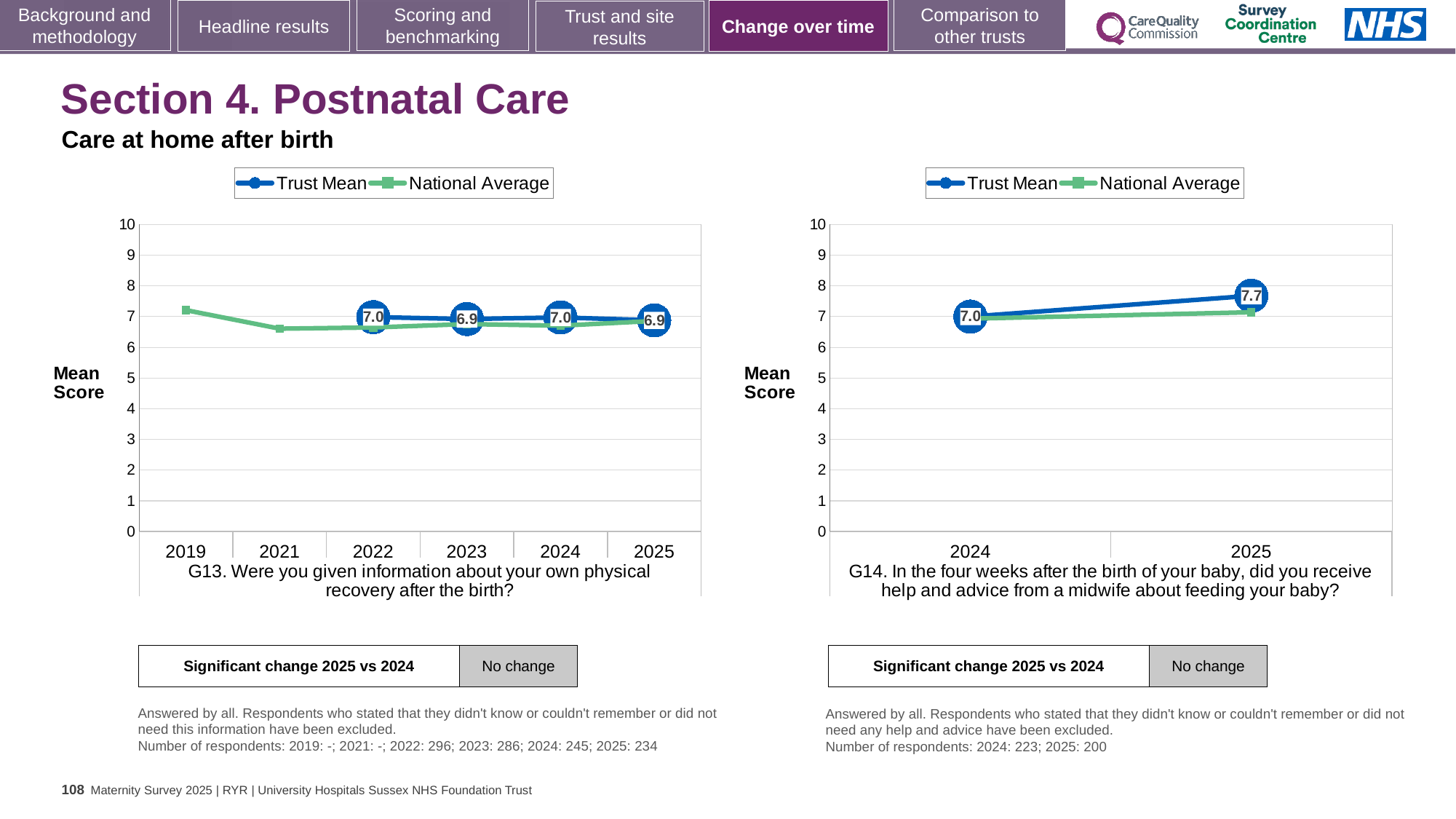
In the G13 chart on the left, what is the Trust Mean for 2022? 7.0 How many years are shown on the x axis of the G13 chart on the left? 6 In the G14 chart on the right, by how much did the Trust Mean change from 2024 to 2025? 0.7 In the G14 chart on the right, what is the Trust Mean for 2025? 7.7 In the G14 chart on the right, which is larger in 2025, the Trust Mean or the National Average? Trust Mean In the G14 chart on the right, what is the Trust Mean for 2024? 7.0 How many series does the legend of the G13 chart on the left list? 2 In the G14 chart on the right, does the Trust Mean rise or fall from 2024 to 2025? rise How many years are shown on the x axis of the G14 chart on the right? 2 In the G13 chart on the left, is the National Average for 2021 greater or less than 7? less In the G13 chart on the left, what is the Trust Mean for 2025? 6.9 What kind of chart is the G14 chart on the right? line chart